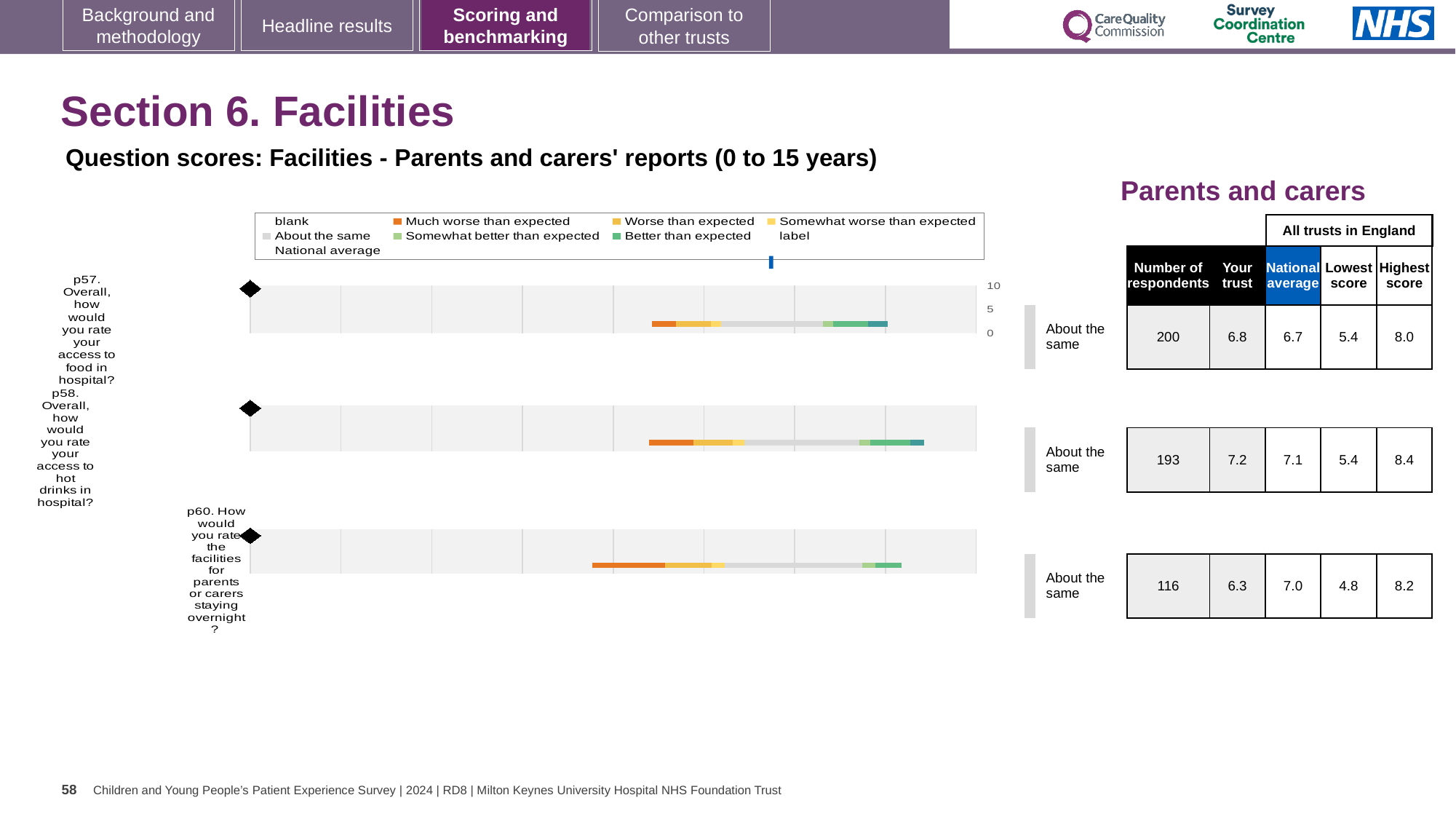
What is the lowest score across all trusts in England for p60? 4.8 What kind of chart is used to show the question scores? bar chart Is the 'Your trust' score for p57 larger or smaller than the national average for p57? larger What is the difference between the 'Your trust' score and the national average for p60? 0.7 How many respondents answered p60 (facilities for parents or carers staying overnight)? 116 Which of the three questions has the highest 'Your trust' score? p58. Overall, how would you rate your access to hot drinks in hospital? What benchmark category is shown for all three questions? About the same What is the national average score for p58 (access to hot drinks in hospital)? 7.1 How many survey questions are plotted on the chart? 3 What is the 'Your trust' score for p57 (access to food in hospital)? 6.8 What is the highest score across all trusts in England for p58? 8.4 Which of the three questions has the lowest number of respondents? p60. How would you rate the facilities for parents or carers staying overnight?